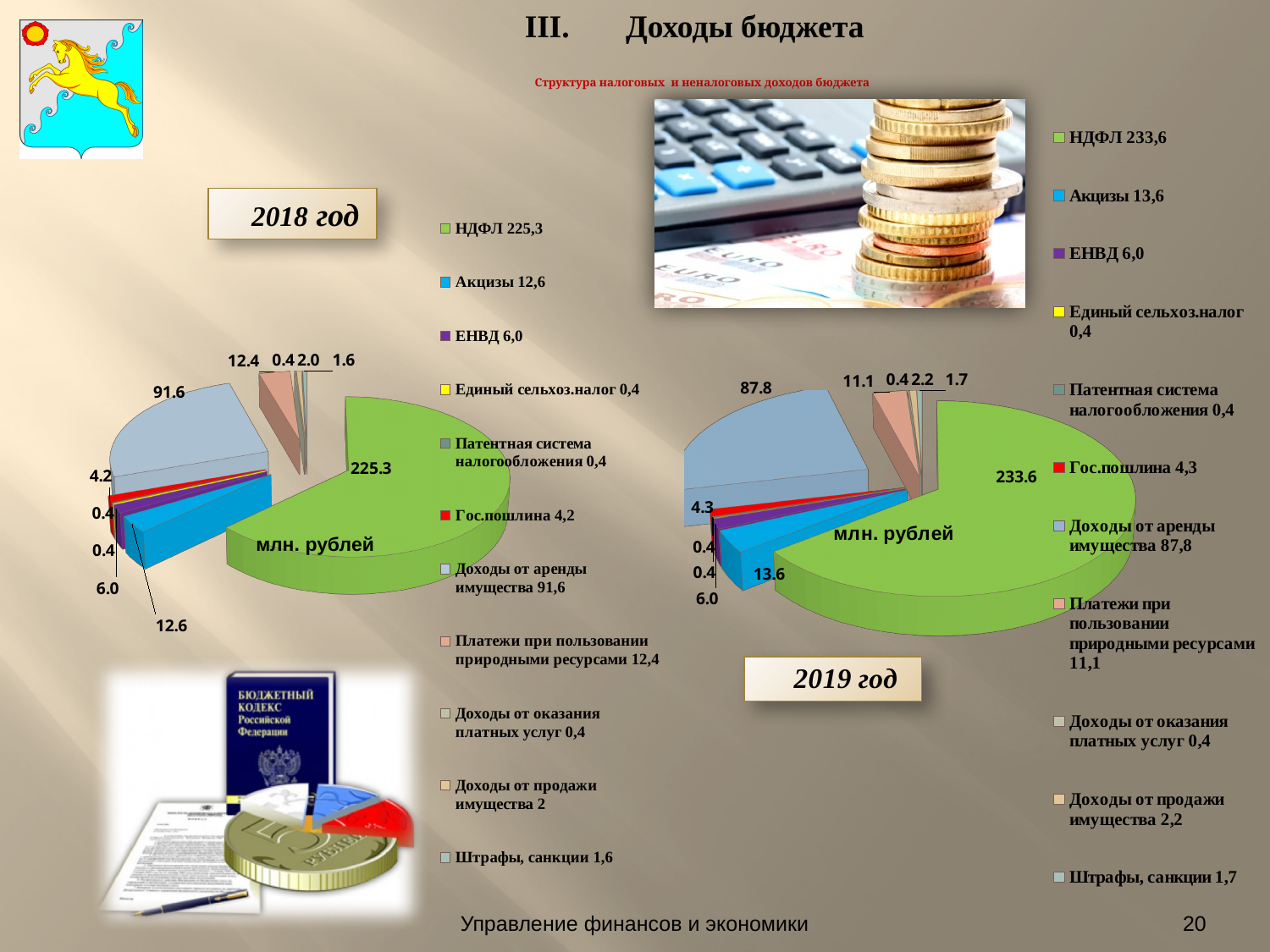
In the 2019 год chart, which category has the largest slice? НДФЛ How many categories does the legend of the 2019 год chart list? 11 In the 2019 год chart, which is larger: Акцизы or Платежи при пользовании природными ресурсами? Акцизы In the 2019 год chart, what is the value for Доходы от аренды имущества? 87.8 In the 2018 год chart, what is the value for Штрафы, санкции? 1.6 In the 2019 год chart, what is the value for Гос.пошлина? 4.3 How much larger is НДФЛ in the 2019 год chart than in the 2018 год chart? 8.3 What kind of chart is used for the 2018 год chart? pie chart What unit is written in the centre of the 2018 год chart? млн. рублей In the 2018 год chart, what is the difference between Доходы от аренды имущества and Акцизы? 79.0 In the 2018 год chart, what is the value for НДФЛ? 225.3 In the 2018 год chart, which category has the largest slice? НДФЛ